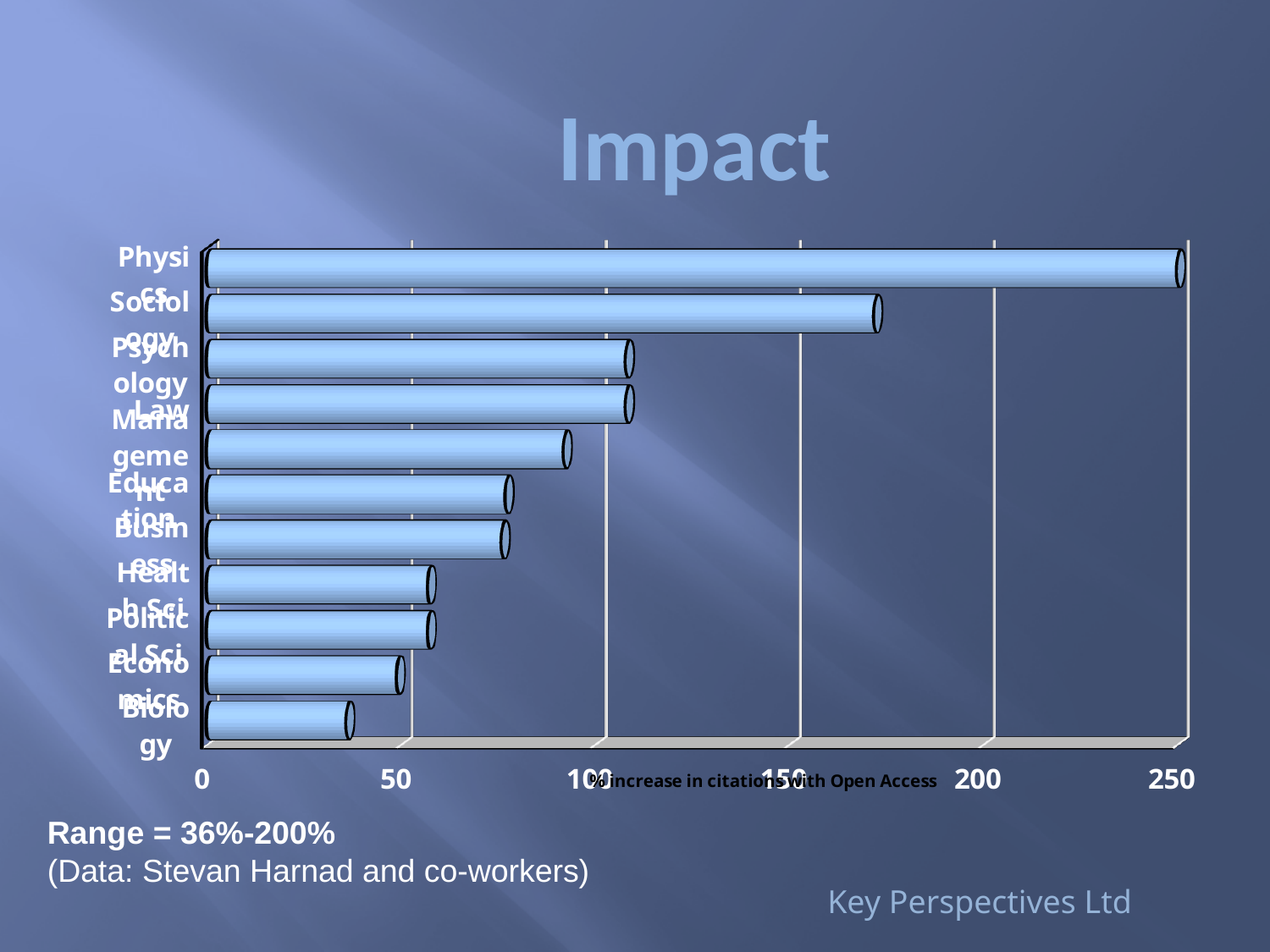
Is the value for Biology greater or less than 50? less How many categories (disciplines) are plotted in the chart? 11 Is the value for Education greater or less than 50? greater Which discipline has the lowest % increase in citations with Open Access? Biology Which discipline has the highest % increase in citations with Open Access? Physics What kind of chart is shown on the slide? bar chart Which has a larger value, Economics or Management? Management Is the value for Sociology greater or less than 150? greater What is the label on the horizontal axis of the chart? % increase in citations with Open Access What is the title of the chart? Impact Which has a larger value, Sociology or Psychology? Sociology